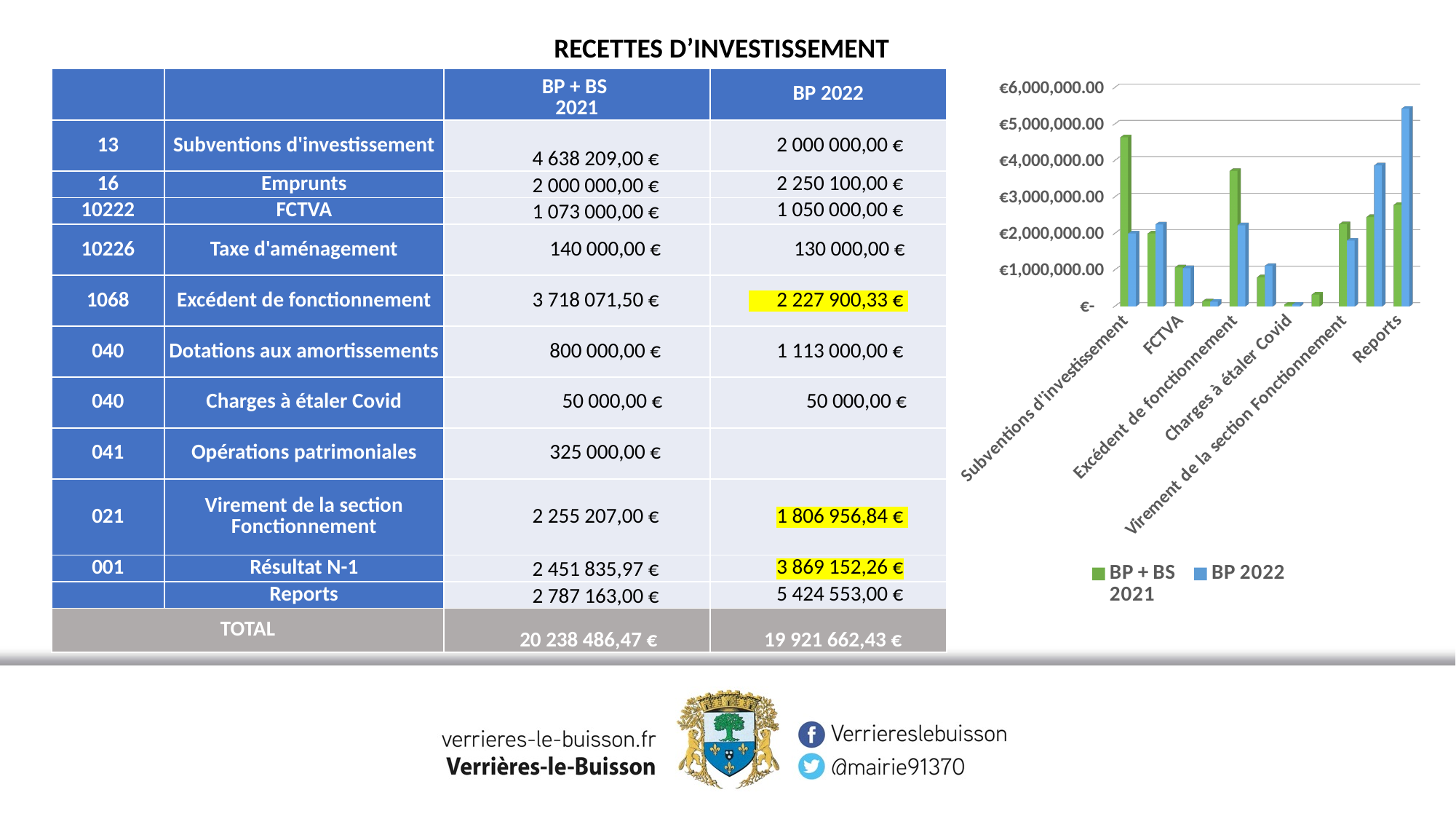
What are the two series named in the chart's legend? BP + BS 2021 and BP 2022 For Subventions d'investissement, which series has the larger bar, BP + BS 2021 or BP 2022? BP + BS 2021 Is the BP 2022 value for FCTVA greater or less than €2,000,000.00? less For Reports, which series has the larger bar, BP + BS 2021 or BP 2022? BP 2022 Is the BP + BS 2021 value for Subventions d'investissement greater or less than €4,000,000.00? greater Which category has the tallest BP + BS 2021 bar in the chart? Subventions d'investissement Is the BP + BS 2021 value for Excédent de fonctionnement greater or less than €3,000,000.00? greater What kind of chart is shown on the right of the slide? bar chart How many series does the chart's legend list? 2 What is the highest value shown on the chart's vertical axis? €6,000,000.00 Which category has the tallest BP 2022 bar in the chart? Reports